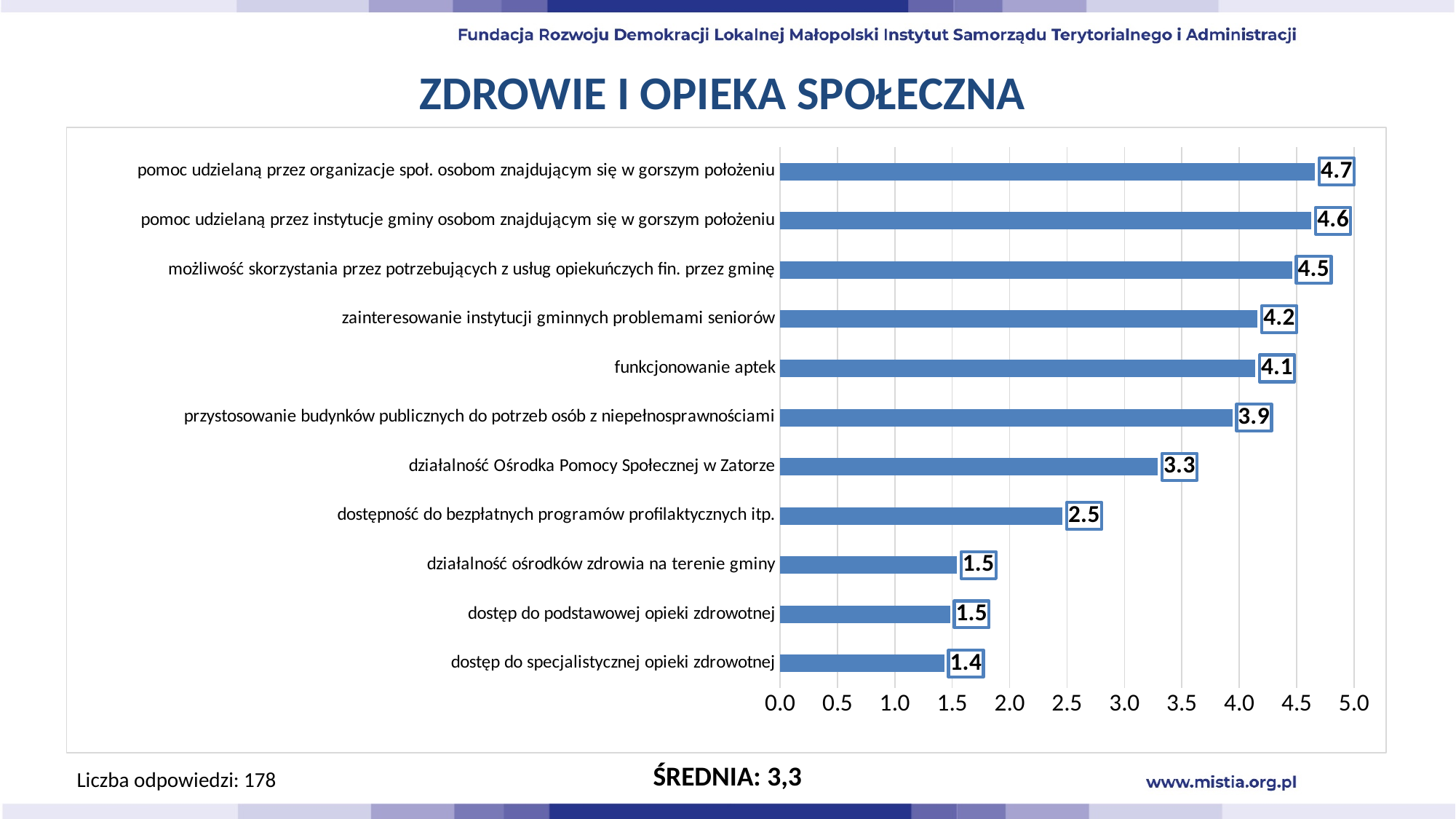
What is the value for "funkcjonowanie aptek"? 4.1 What is the difference between the highest value (4.7) and the lowest value (1.4)? 3.3 What kind of chart is shown on the slide? bar chart Which is larger: the value for "funkcjonowanie aptek" or for "działalność Ośrodka Pomocy Społecznej w Zatorze"? funkcjonowanie aptek What is the title of the chart? ZDROWIE I OPIEKA SPOŁECZNA Is the value for "dostępność do bezpłatnych programów profilaktycznych itp." greater or less than 3.0? less What is the value for "dostępność do bezpłatnych programów profilaktycznych itp."? 2.5 What is the value for "działalność Ośrodka Pomocy Społecznej w Zatorze"? 3.3 Which category has the lowest value? dostęp do specjalistycznej opieki zdrowotnej What is the difference between "zainteresowanie instytucji gminnych problemami seniorów" and "działalność Ośrodka Pomocy Społecznej w Zatorze"? 0.9 How many categories are shown in the chart? 11 Which category has the highest value? pomoc udzielaną przez organizacje społ. osobom znajdującym się w gorszym położeniu